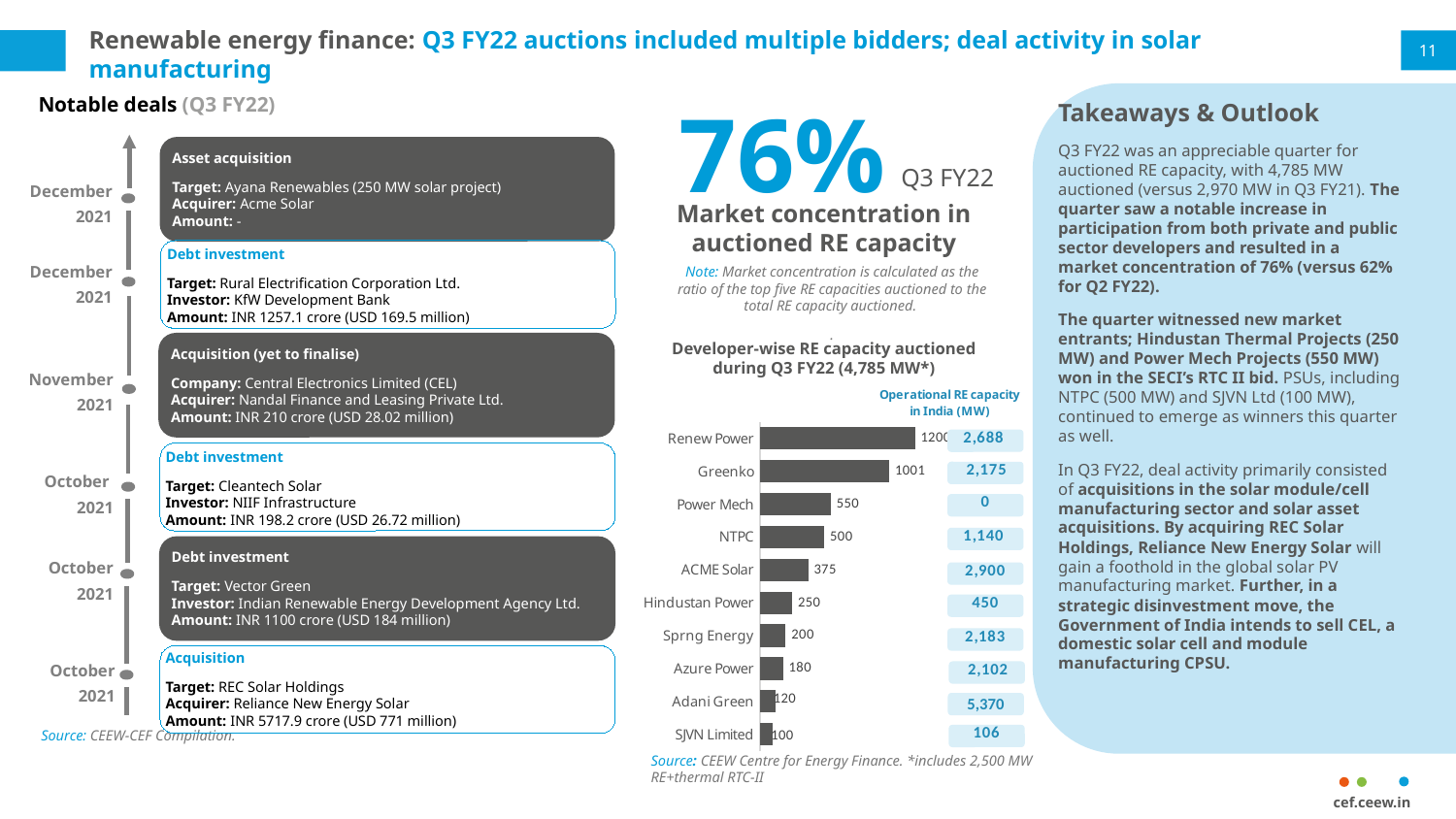
What is the RE capacity auctioned for Greenko in Q3 FY22? 1001 How many developers are shown in the developer-wise RE capacity auctioned chart? 10 Which has a larger RE capacity auctioned in Q3 FY22, Hindustan Power or Sprng Energy? Hindustan Power What is the difference between the RE capacity auctioned for Adani Green and SJVN Limited? 20 What is the difference between the RE capacity auctioned for Power Mech and NTPC? 50 Which developer has the lowest RE capacity auctioned during Q3 FY22? SJVN Limited What is the RE capacity auctioned for Power Mech in Q3 FY22? 550 Which developer has the highest RE capacity auctioned during Q3 FY22? Renew Power What is the RE capacity auctioned for Azure Power in Q3 FY22? 180 What is the RE capacity auctioned for ACME Solar in Q3 FY22? 375 What type of chart is used to show developer-wise RE capacity auctioned during Q3 FY22? Bar chart What total RE capacity auctioned during Q3 FY22 is stated in the chart title? 4,785 MW